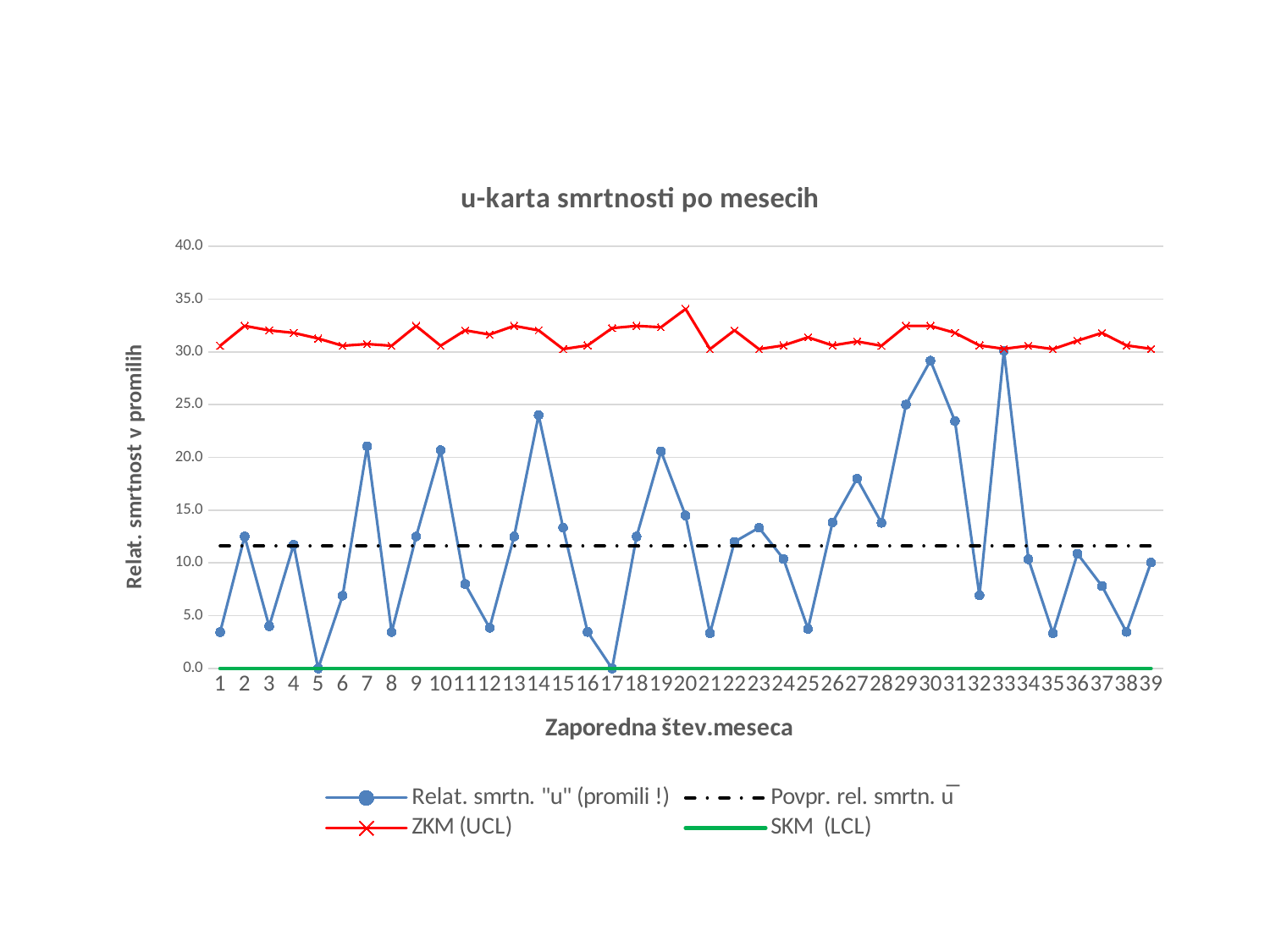
What is the value of Relat. smrtn. "u" (promili !) for month 17? 0.0 What is the value of Relat. smrtn. "u" (promili !) for month 5? 0.0 How many months are plotted along the x axis? 39 Is the value of Relat. smrtn. "u" (promili !) for month 33 greater or less than 25.0? greater Which month has the larger value of Relat. smrtn. "u" (promili !), month 14 or month 15? month 14 What is the title of the chart? u-karta smrtnosti po mesecih Does the Relat. smrtn. "u" (promili !) line rise or fall from month 28 to month 30? rise What value does the SKM (LCL) line hold across all months? 0.0 What kind of chart is shown on the slide? line chart Is the value of Relat. smrtn. "u" (promili !) for month 1 greater or less than 5.0? less How many series does the legend list? 4 Is the value of ZKM (UCL) for month 20 greater or less than 30.0? greater